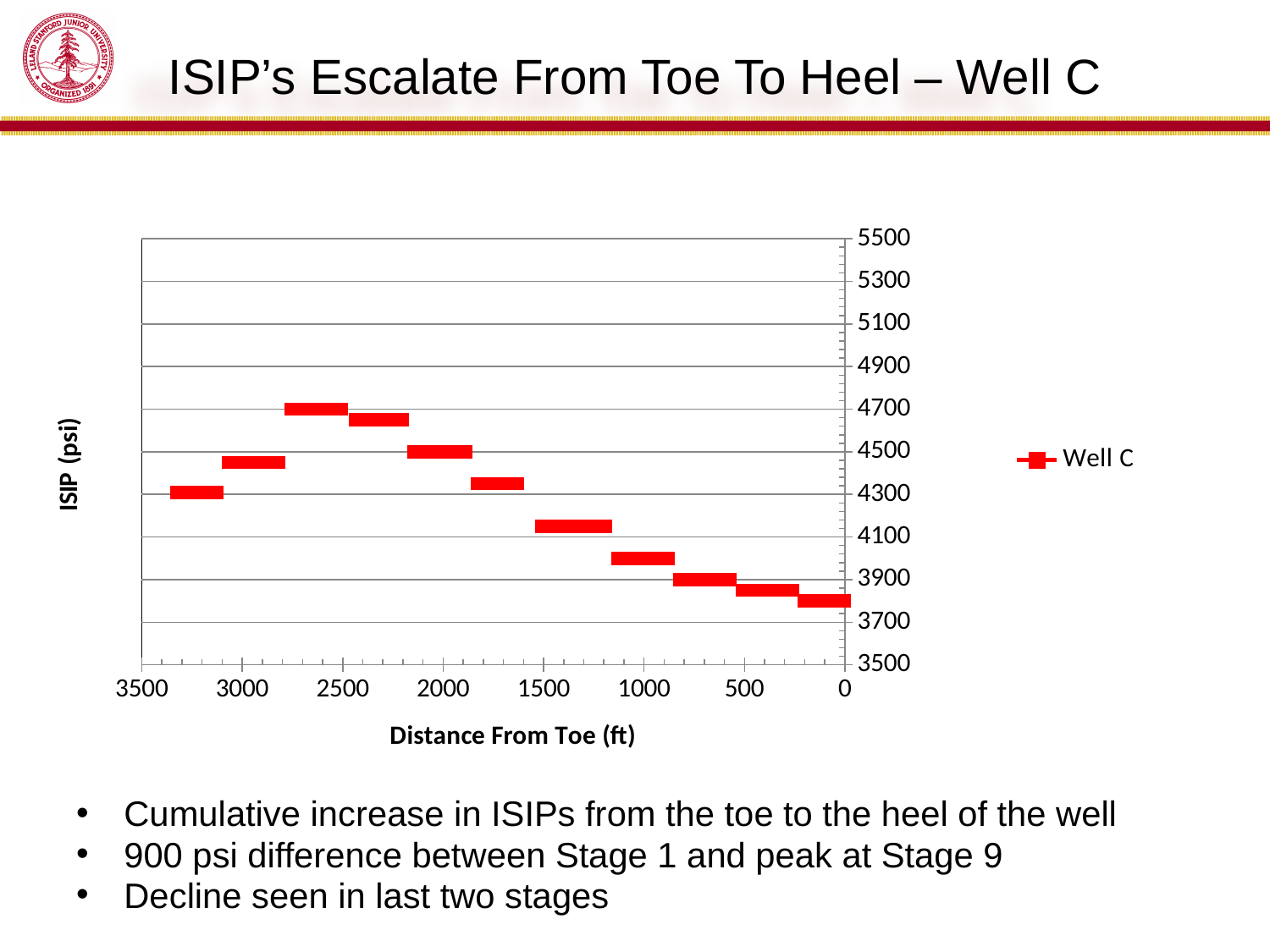
How many series does the legend list? 1 Is the ISIP value for the marker nearest 3300 ft greater or less than 4500? less What is the title of the y axis? ISIP (psi) How many data markers are plotted for Well C? 11 Is the ISIP value for the marker nearest 3300 ft greater or less than 4100? greater Which has the larger ISIP value: the marker nearest 3300 ft or the marker nearest 0 ft? the marker nearest 3300 ft Moving from the 0 ft end of the x axis toward the 3500 ft end, do the ISIP values generally rise or fall? rise What is the name of the series shown in the legend? Well C Is the ISIP value for the marker nearest 1300 ft greater or less than 4300? less Which has the larger ISIP value: the marker nearest 2600 ft or the marker nearest 3000 ft? the marker nearest 2600 ft